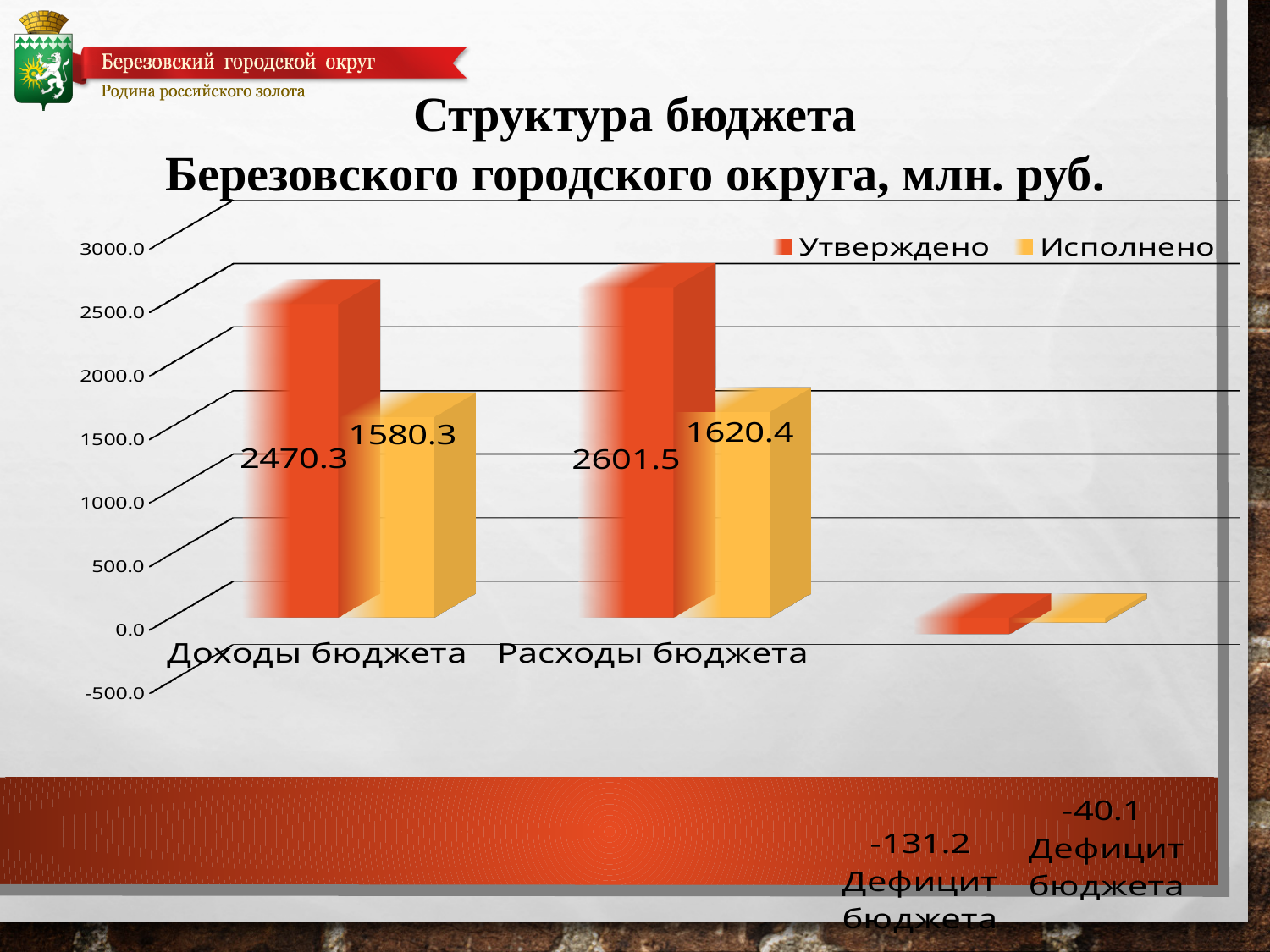
What is the difference between the Утверждено values for Расходы бюджета and Доходы бюджета? 131.2 What is the Исполнено value for Дефицит бюджета? -40.1 Which is larger: the Исполнено value for Доходы бюджета or for Расходы бюджета? Расходы бюджета Which category has the highest Утверждено value? Расходы бюджета What is the Исполнено value for Расходы бюджета? 1620.4 Which series is shown in yellow in the legend? Исполнено What is the Исполнено value for Доходы бюджета? 1580.3 What is the Утверждено value for Дефицит бюджета? -131.2 What is the difference between the Утверждено and Исполнено values for Расходы бюджета? 981.1 How many series does the legend list? 2 What is the Утверждено value for Доходы бюджета? 2470.3 What kind of chart is shown on the slide? Bar chart